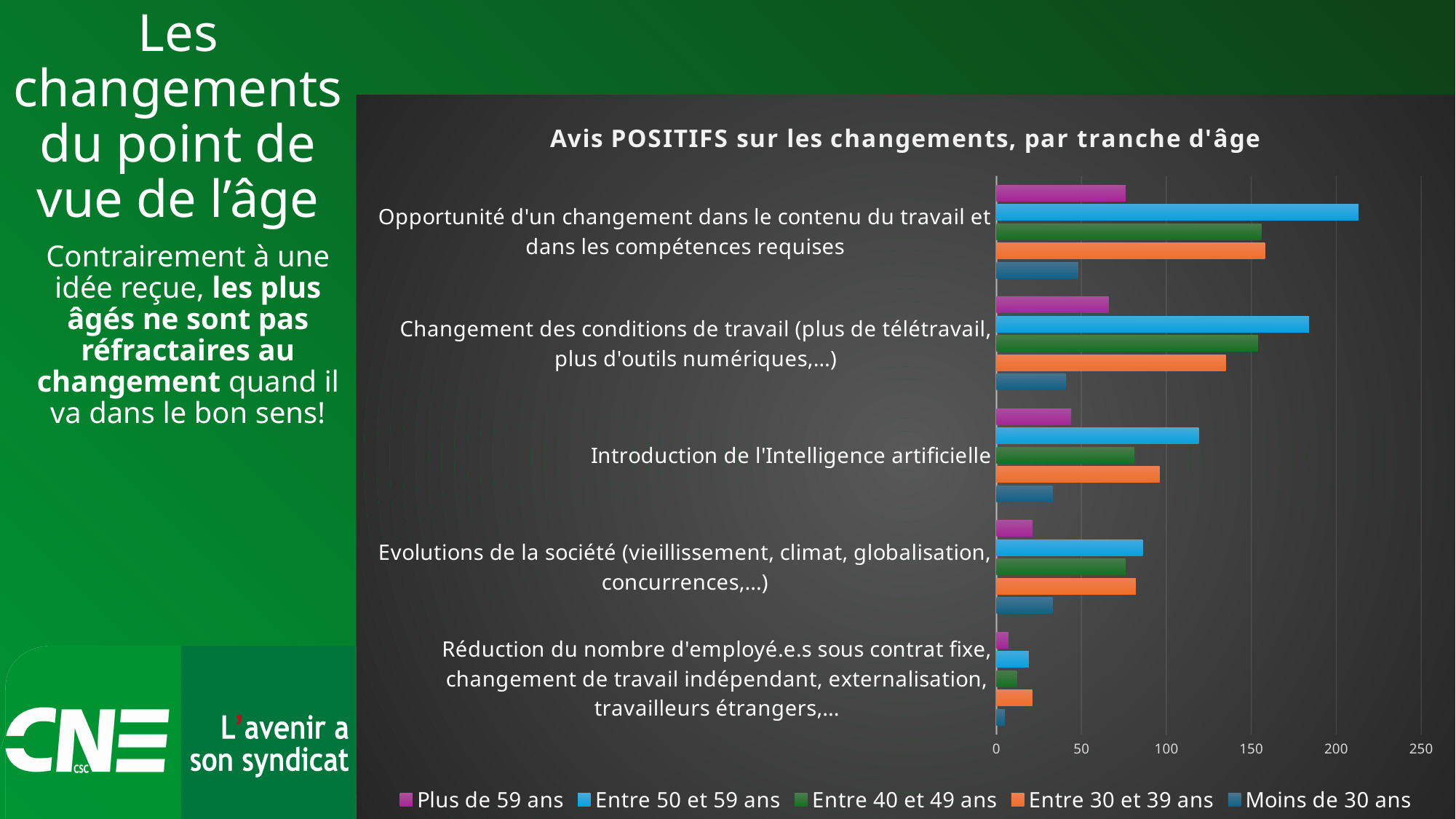
Which colour represents the series 'Entre 30 et 39 ans' in the chart? orange Is the value for 'Entre 50 et 59 ans' in the category 'Opportunité d'un changement dans le contenu du travail et dans les compétences requises' greater or less than 200? greater For which category is the value for 'Entre 50 et 59 ans' the highest? Opportunité d'un changement dans le contenu du travail et dans les compétences requises In the category 'Introduction de l'Intelligence artificielle', which is larger: the value for 'Entre 30 et 39 ans' or for 'Entre 40 et 49 ans'? Entre 30 et 39 ans What kind of chart is shown on the slide? bar chart How many categories (types of change) are shown on the chart? 5 Is the value for 'Entre 30 et 39 ans' in the category 'Changement des conditions de travail (plus de télétravail, plus d'outils numériques,…)' greater or less than 150? less Is the value for 'Entre 50 et 59 ans' in the category 'Introduction de l'Intelligence artificielle' greater or less than 100? greater What is the title of the chart? Avis POSITIFS sur les changements, par tranche d'âge In the category 'Evolutions de la société (vieillissement, climat, globalisation, concurrences,…)', which age group has the lowest value? Plus de 59 ans How many series does the legend of the chart list? 5 For which category is the value for 'Entre 50 et 59 ans' the lowest? Réduction du nombre d'employé.e.s sous contrat fixe, changement de travail indépendant, externalisation, travailleurs étrangers,…